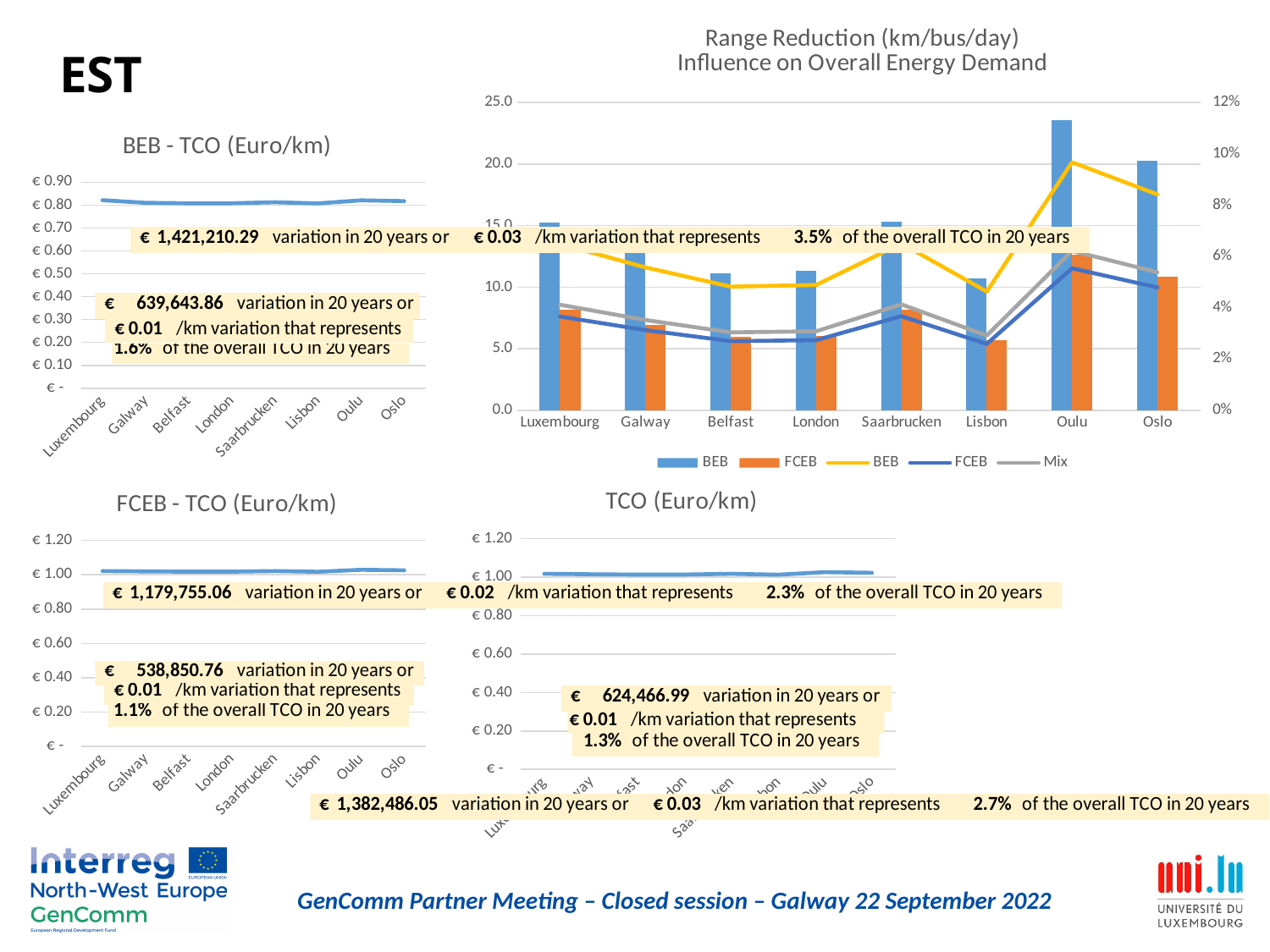
On the 'BEB - TCO (Euro/km)' chart, is the value for Luxembourg greater or less than € 0.90? less On the 'Range Reduction (km/bus/day) Influence on Overall Energy Demand' chart, which city has the tallest BEB bar? Oulu On the 'Range Reduction (km/bus/day) Influence on Overall Energy Demand' chart, is the FCEB bar for Luxembourg greater or less than 5.0? greater On the 'Range Reduction (km/bus/day) Influence on Overall Energy Demand' chart, is the BEB bar for Oulu greater or less than 20.0? greater On the 'Range Reduction (km/bus/day) Influence on Overall Energy Demand' chart, how many series does the legend list? 5 On the 'Range Reduction (km/bus/day) Influence on Overall Energy Demand' chart, how many cities are shown on the x axis? 8 On the 'Range Reduction (km/bus/day) Influence on Overall Energy Demand' chart, does the BEB line rise or fall from Lisbon to Oulu? rise What kind of chart is the 'BEB - TCO (Euro/km)' chart on the left of the slide? line chart On the 'Range Reduction (km/bus/day) Influence on Overall Energy Demand' chart, which series is drawn as a grey line? Mix On the 'Range Reduction (km/bus/day) Influence on Overall Energy Demand' chart, which has the larger BEB bar, Luxembourg or Belfast? Luxembourg